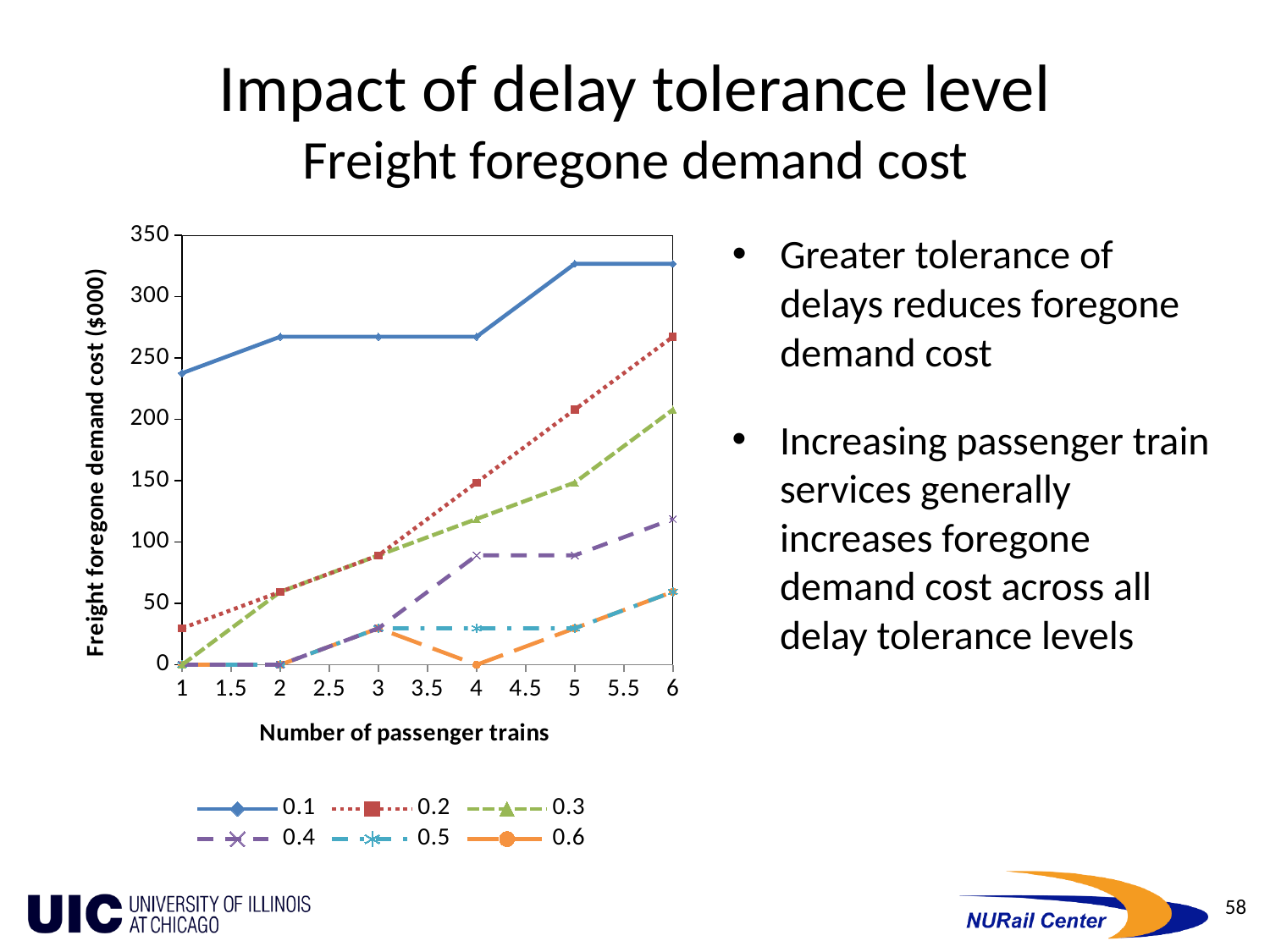
Which series has the lowest freight foregone demand cost at 4 passenger trains? 0.6 Does the freight foregone demand cost for series 0.2 rise or fall as the number of passenger trains increases? rise Is the value for series 0.4 at 6 passenger trains greater or less than 100? greater Is the value for series 0.1 at 6 passenger trains greater or less than 300? greater What is the title of the y axis? Freight foregone demand cost ($000) How many series does the legend list? 6 At 6 passenger trains, which is larger: the value for series 0.2 or series 0.3? 0.2 How many passenger-train values (data points) are plotted for each series along the x axis? 6 Is the value for series 0.2 at 1 passenger train greater or less than 50? less Which series has the highest freight foregone demand cost at 6 passenger trains? 0.1 What kind of chart is shown on the slide? line chart